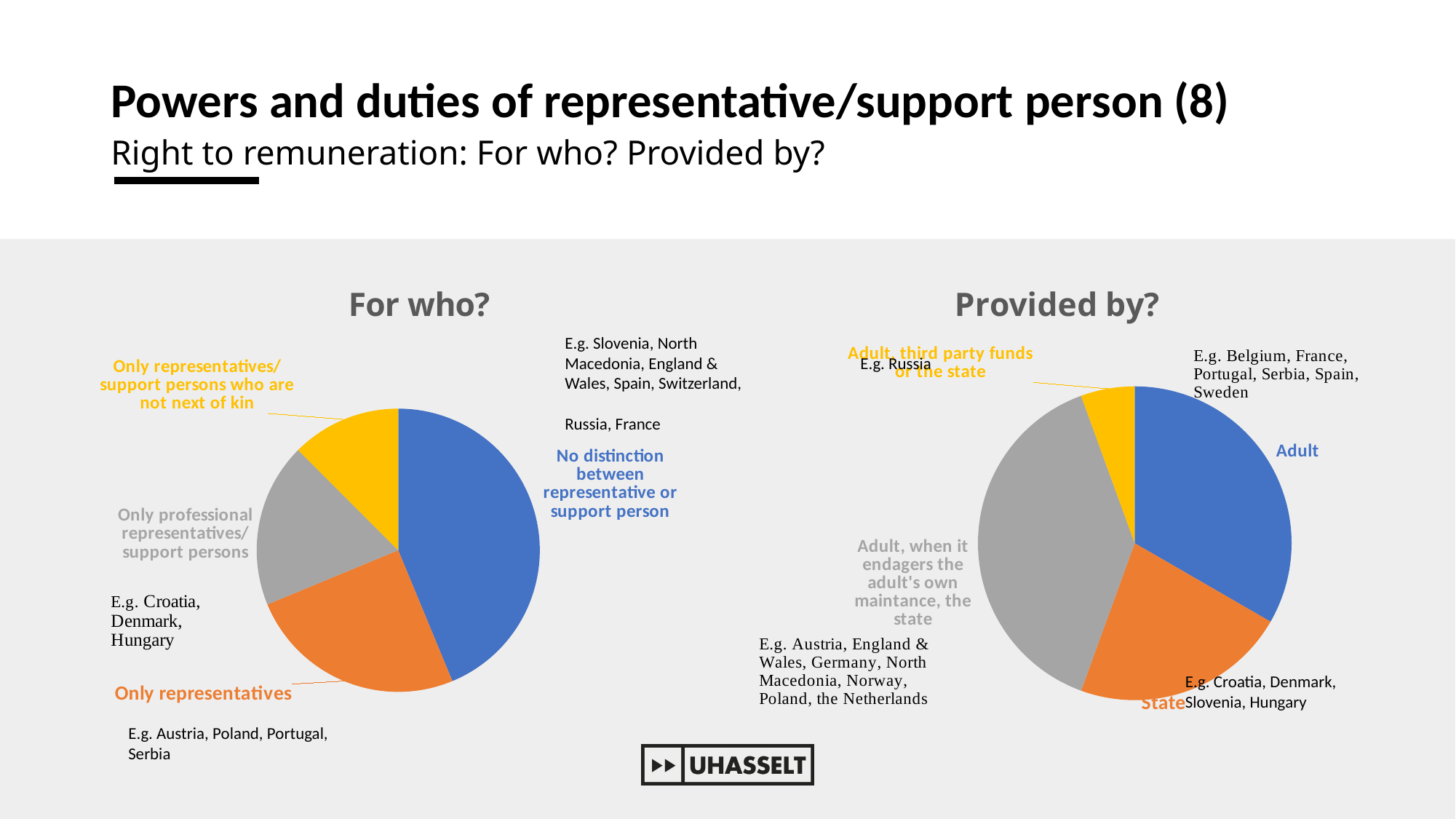
What kind of chart is the "For who?" chart? Pie chart In the "Provided by?" pie chart, which category has the largest slice? Adult, when it endagers the adult's own maintance, the state What kind of chart is the "Provided by?" chart? Pie chart In the "Provided by?" pie chart, which slice is larger: "Adult" or "State"? Adult In the "For who?" pie chart, which slice is larger: "Only representatives" or "Only representatives/support persons who are not next of kin"? Only representatives In the "Provided by?" pie chart, which category has the smallest slice? Adult, third party funds or the state What is the title of the pie chart on the left of the slide? For who? In the "For who?" pie chart, which category has the largest slice? No distinction between representative or support person How many slices does the "For who?" pie chart have? 4 How many slices does the "Provided by?" pie chart have? 4 In the "For who?" pie chart, which category has the smallest slice? Only representatives/support persons who are not next of kin In the "Provided by?" pie chart, what colour is the "State" slice? Orange